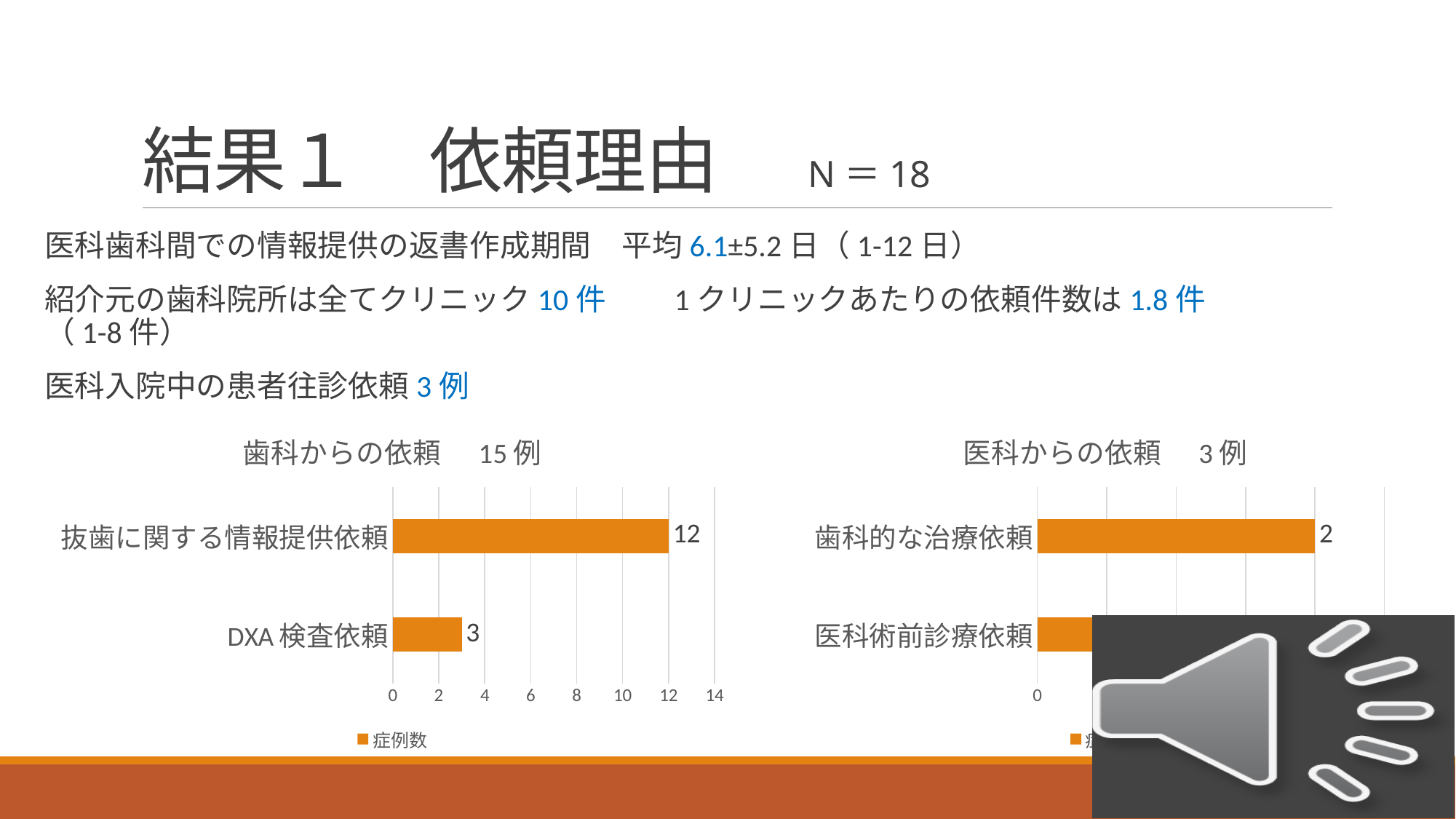
In the chart titled 歯科からの依頼 15例, what is the value for DXA検査依頼? 3 In the chart titled 歯科からの依頼 15例, what is the value for 抜歯に関する情報提供依頼? 12 In the chart titled 歯科からの依頼 15例, is the value for 抜歯に関する情報提供依頼 greater or less than 10? greater In the chart titled 歯科からの依頼 15例, which is larger: 抜歯に関する情報提供依頼 or DXA検査依頼? 抜歯に関する情報提供依頼 How many series does the legend of the chart titled 歯科からの依頼 15例 list? 1 In the chart titled 医科からの依頼 3例, what is the value for 歯科的な治療依頼? 2 In the chart titled 歯科からの依頼 15例, which category has the highest value? 抜歯に関する情報提供依頼 What kind of chart is the chart titled 歯科からの依頼 15例? bar chart In the chart titled 歯科からの依頼 15例, what is the difference between the values for 抜歯に関する情報提供依頼 and DXA検査依頼? 9 What is the legend entry shown under the chart titled 歯科からの依頼 15例? 症例数 In the chart titled 歯科からの依頼 15例, which category has the lowest value? DXA検査依頼 How many categories are shown in the chart titled 歯科からの依頼 15例? 2